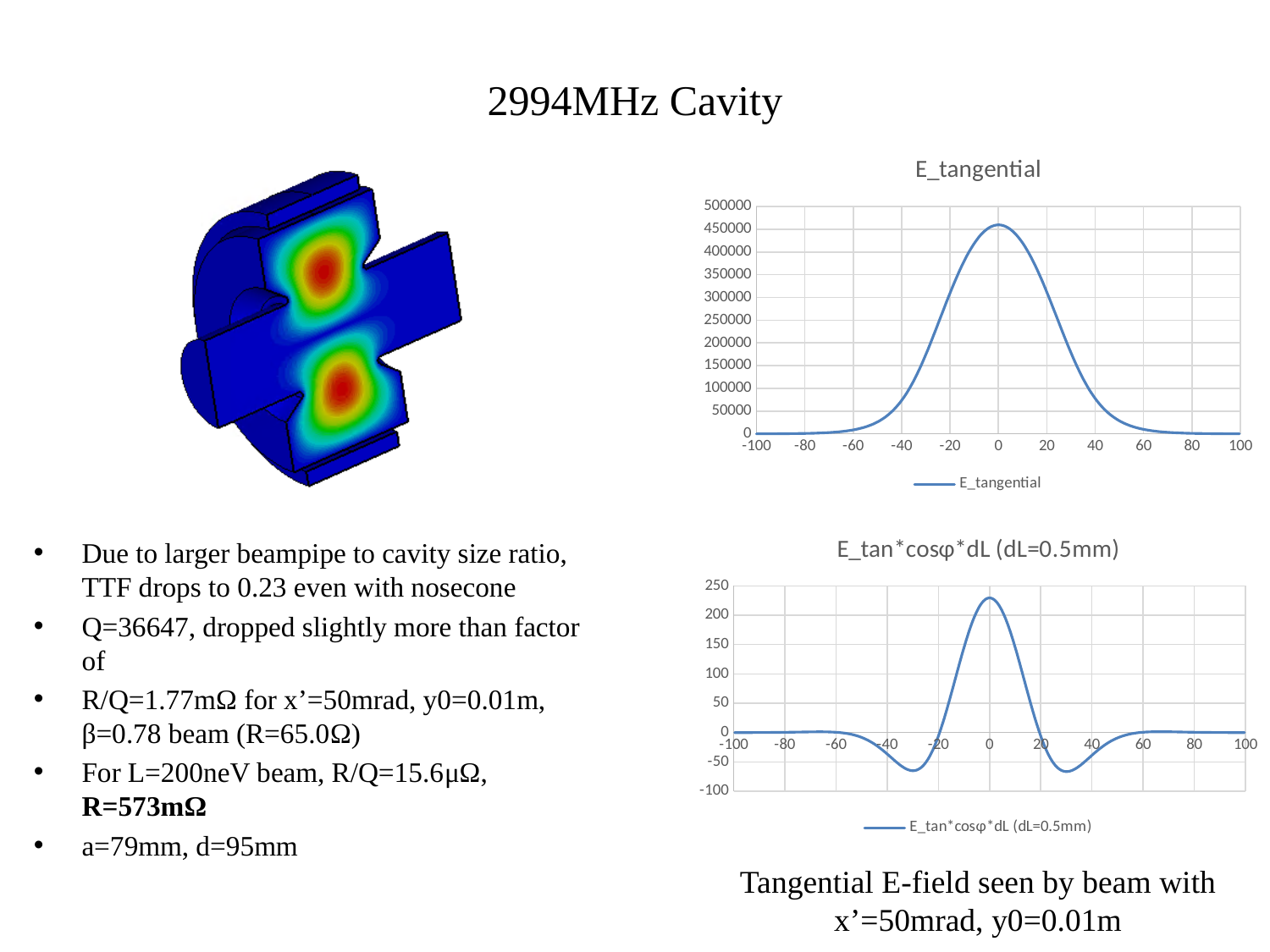
How many series does the legend of the E_tangential chart list? 1 In the E_tangential chart, is the value at x = 0 greater or less than 400000? greater In the E_tan*cosφ*dL (dL=0.5mm) chart, is the value at x = -30 greater or less than 0? less In the E_tangential chart, is the value at x = -40 greater or less than 150000? less What kind of chart is the E_tan*cosφ*dL (dL=0.5mm) chart? line chart In the E_tan*cosφ*dL (dL=0.5mm) chart, do the values rise or fall as x goes from 0 to 30? fall What kind of chart is the E_tangential chart? line chart What is the title of the lower chart on the slide? E_tan*cosφ*dL (dL=0.5mm) In the E_tangential chart, do the values rise or fall as x goes from -100 to 0? rise How many series does the legend of the E_tan*cosφ*dL (dL=0.5mm) chart list? 1